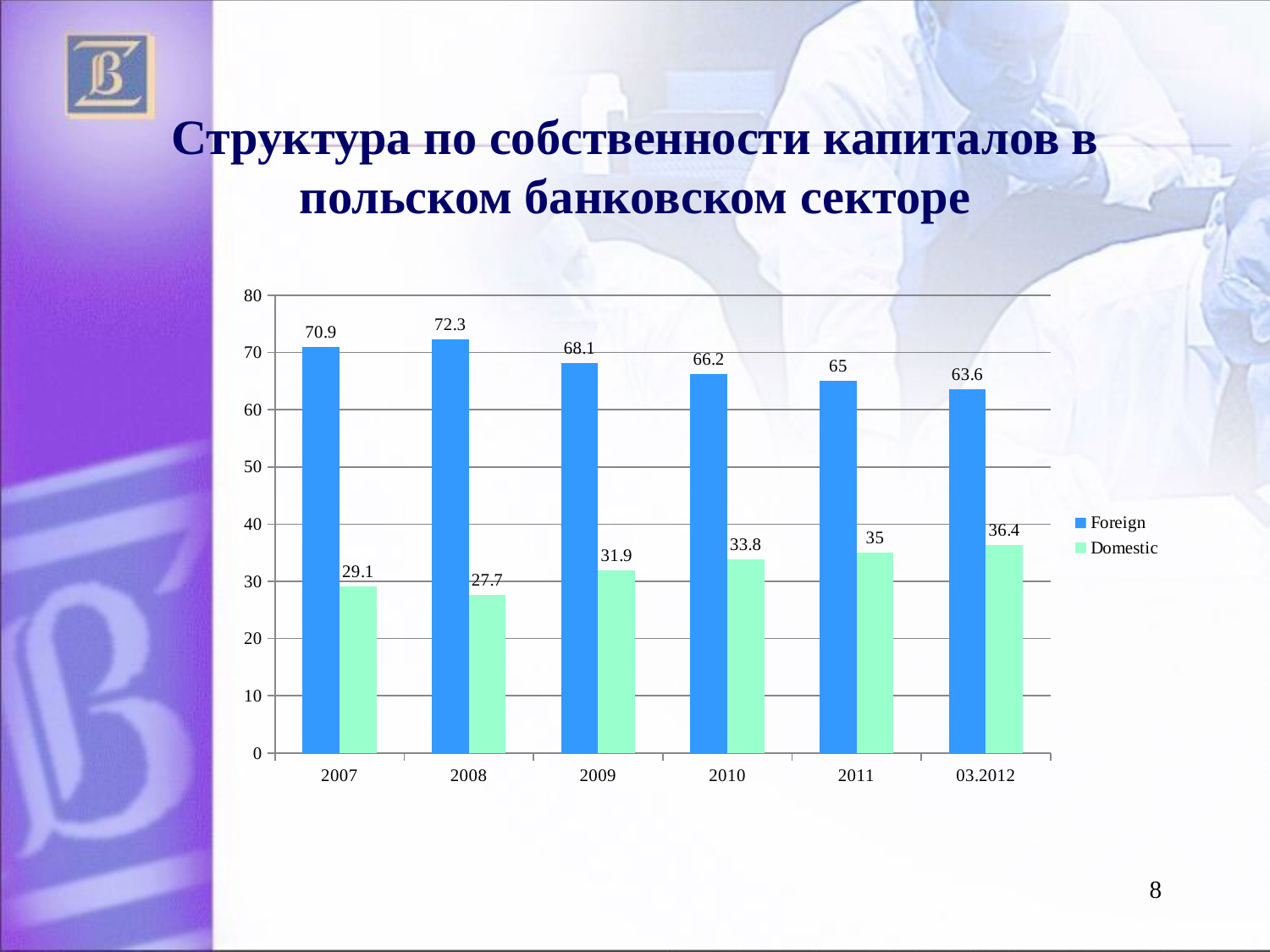
How many time periods are shown on the x axis? 6 Is the Foreign value for 2009 greater or less than 60? greater What is the Foreign value for 2008? 72.3 Which year has the lowest Domestic value? 2008 How many series does the legend list? 2 What is the difference between the Foreign and Domestic values in 2011? 30 What is the Domestic value for 03.2012? 36.4 Which is larger, the Domestic value for 2010 or the Domestic value for 2007? 2010 Does the Domestic value rise or fall from 2008 to 03.2012? rise What is the Domestic value for 2009? 31.9 Which year has the highest Foreign value? 2008 What kind of chart is shown on the slide? bar chart